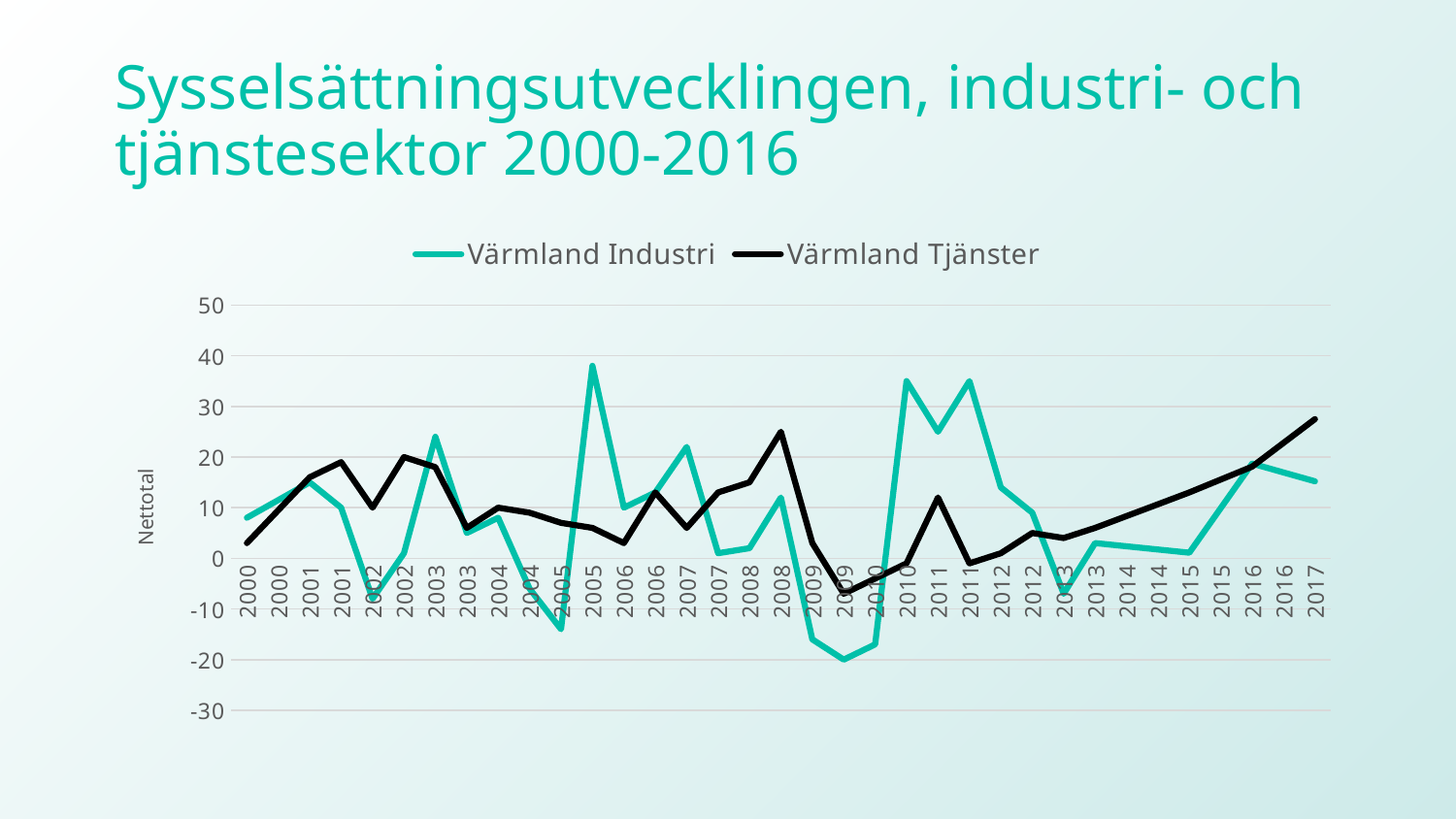
At the 2017 label, which series has the higher value, Värmland Industri or Värmland Tjänster? Värmland Tjänster Is the lowest Värmland Industri value (at the second 2009 label) greater or less than -10? less What is the label on the vertical axis? Nettotal At the second 2010 label, which series has the higher value, Värmland Industri or Värmland Tjänster? Värmland Industri Is the Värmland Tjänster value at the second 2008 label greater or less than 20? greater What are the two series named in the legend? Värmland Industri and Värmland Tjänster Is the Värmland Industri value at the first 2005 label greater or less than 30? less Which series reaches the lowest value on the chart, and at which year label? Värmland Industri, at 2009 Does the Värmland Tjänster line rise or fall from the 2013 labels to the 2017 label? rise How many series does the legend list? 2 What kind of chart is shown on the slide? line chart